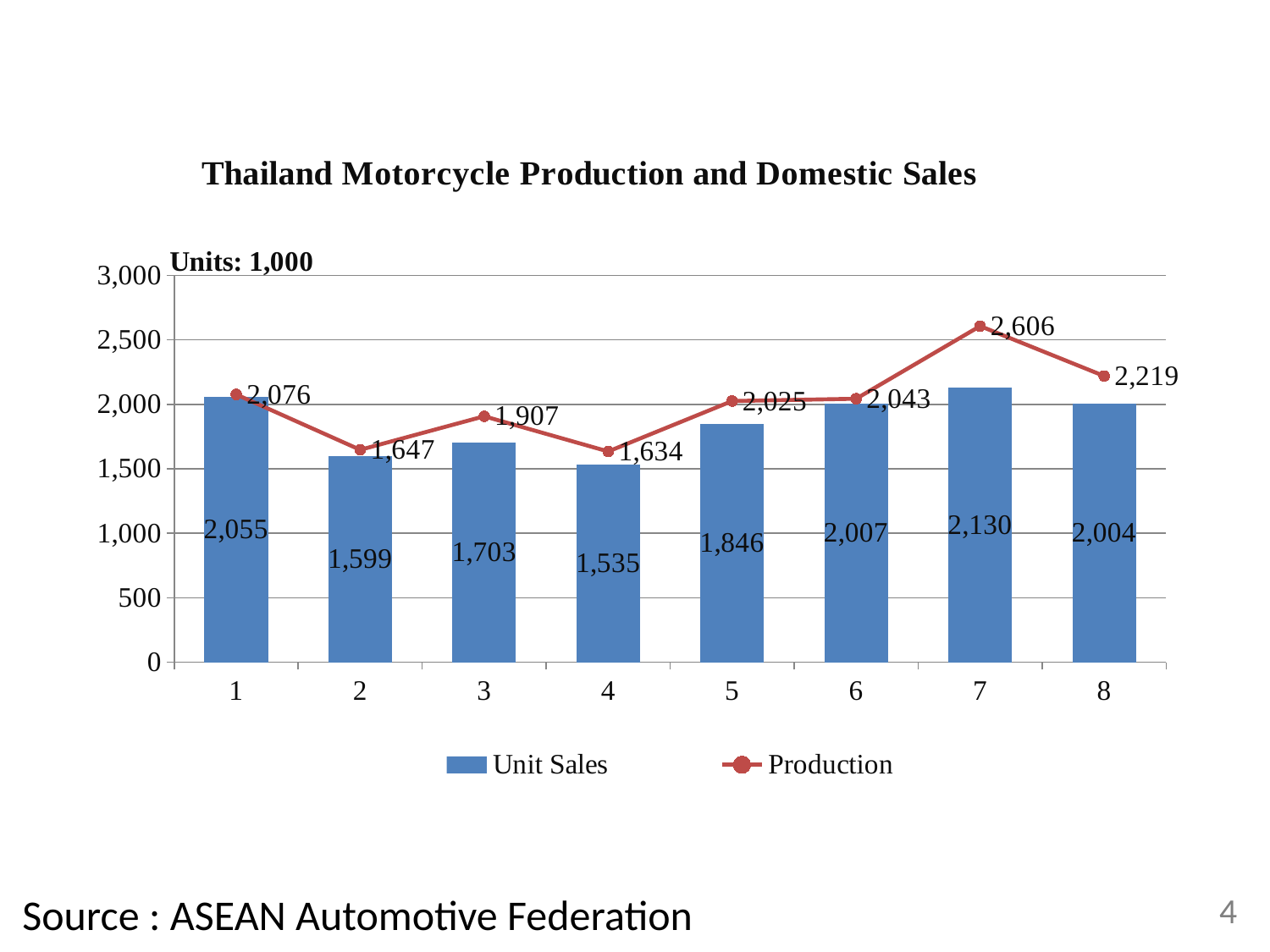
Which category has the highest Production value? 7 What is the Production value for category 8? 2,219 Does the Production value rise or fall from category 7 to category 8? Fall What kind of chart is used for the Unit Sales series? Bar chart How many series does the legend list? 2 What is the Unit Sales value for category 7? 2,130 Which category has the lowest Unit Sales value? 4 How many categories are shown on the x axis? 8 What is the title of the chart? Thailand Motorcycle Production and Domestic Sales What is the difference between Production and Unit Sales for category 7? 476 Which is larger for category 2: Unit Sales or Production? Production What is the Production value for category 4? 1,634